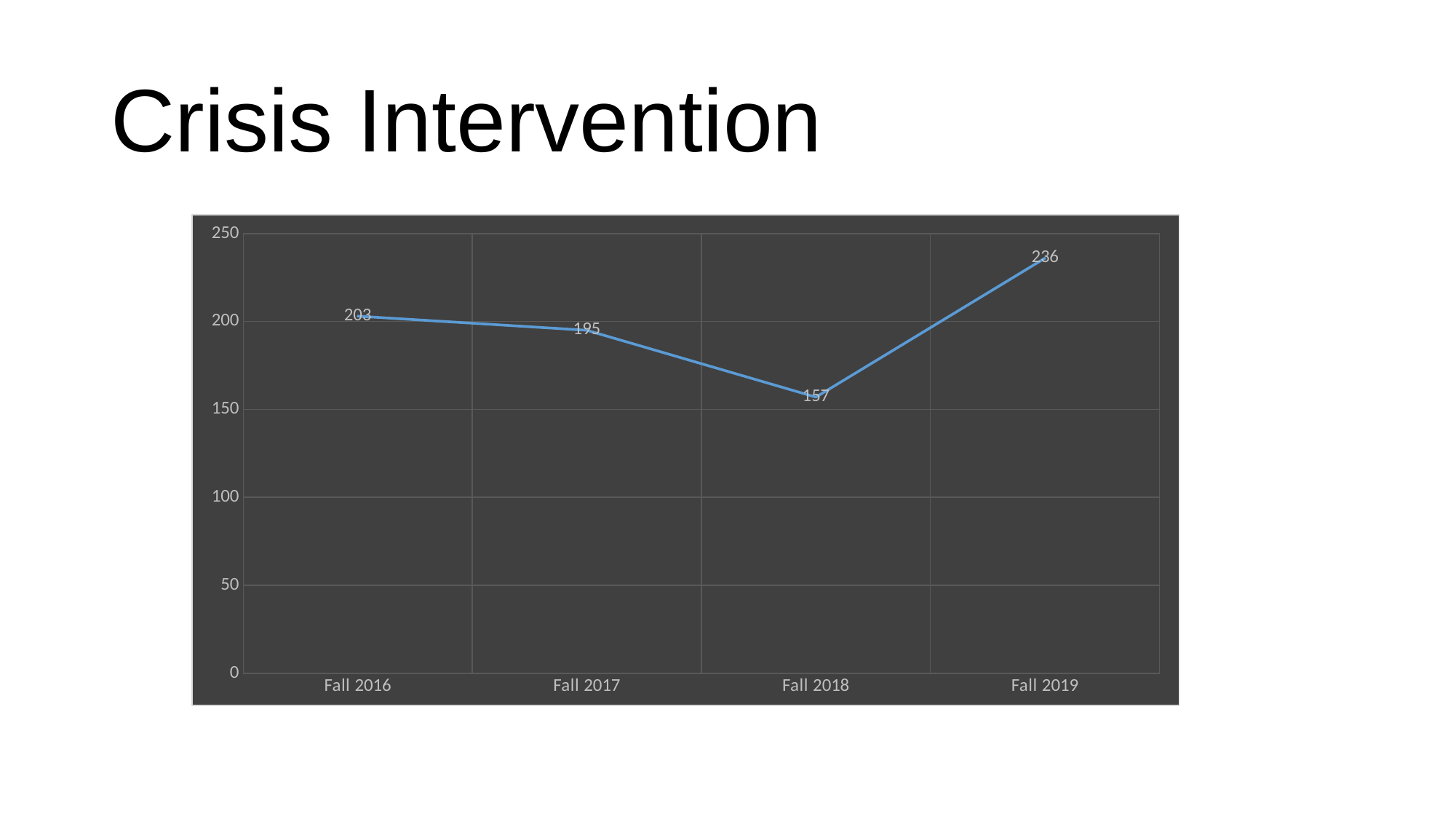
What is the difference between the values for Fall 2019 and Fall 2018? 79 Do the values rise or fall from Fall 2016 to Fall 2018? Fall Which is larger, the value for Fall 2016 or the value for Fall 2018? Fall 2016 What kind of chart is shown on the slide? Line chart What is the value for Fall 2018? 157 What is the value for Fall 2016? 203 Which period has the highest value? Fall 2019 What is the value for Fall 2019? 236 What is the difference between the values for Fall 2016 and Fall 2017? 8 What is the value for Fall 2017? 195 Which period has the lowest value? Fall 2018 How many data points are plotted on the chart? 4